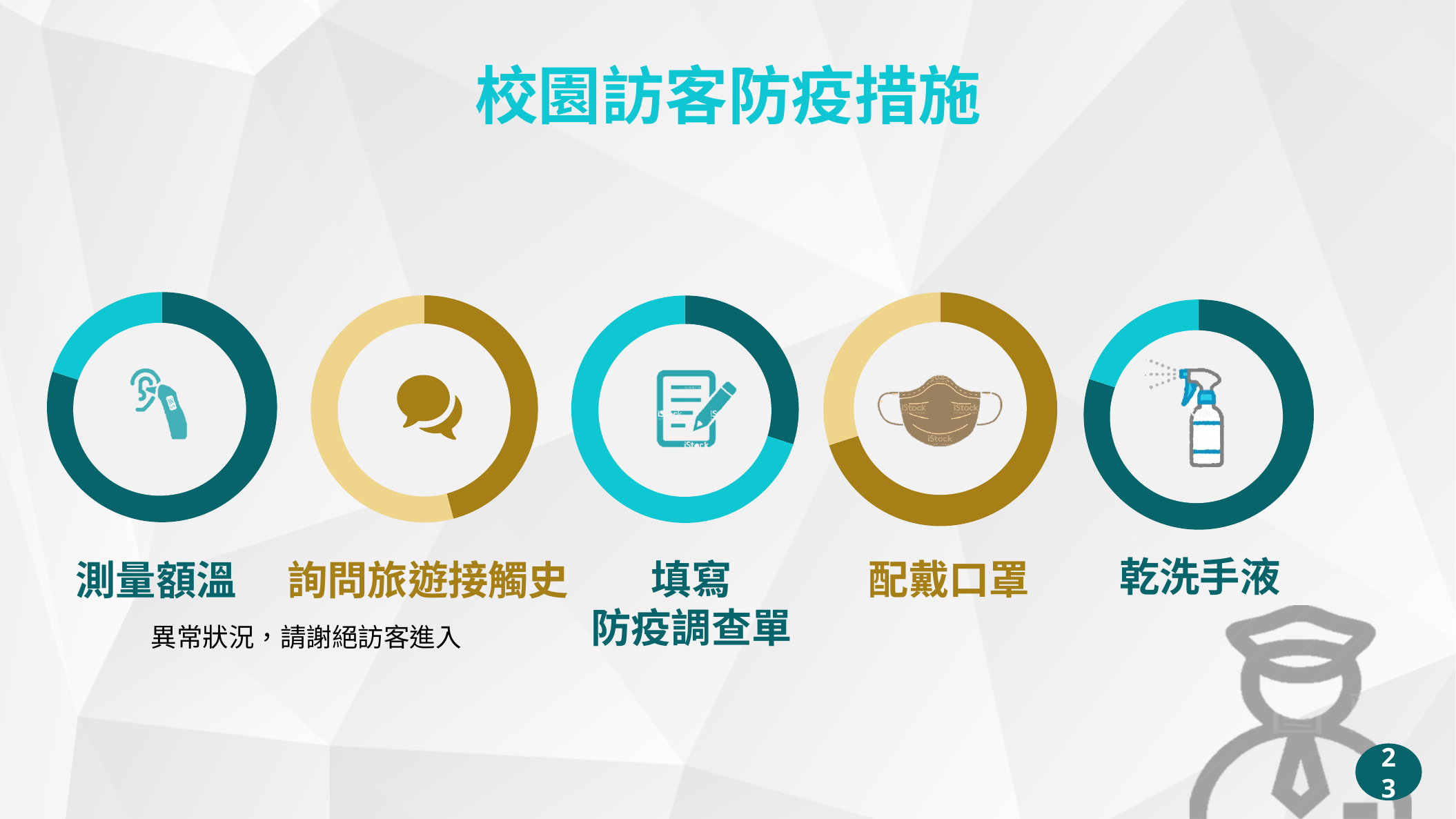
How many doughnut ring charts are shown on the slide? 5 In the second ring chart (詢問旅遊接觸史), which colour segment is larger, the light gold or the dark gold? light gold In the first ring chart (測量額溫), which colour segment is larger, the dark teal or the light teal? dark teal In the third ring chart (填寫防疫調查單), which colour segment is larger, the light teal or the dark teal? light teal What label appears under the fourth ring chart? 配戴口罩 What is the title of the slide containing the ring charts? 校園訪客防疫措施 What kind of chart is used for each of the five ring graphics on the slide? doughnut chart How many segments does each ring chart on the slide have? 2